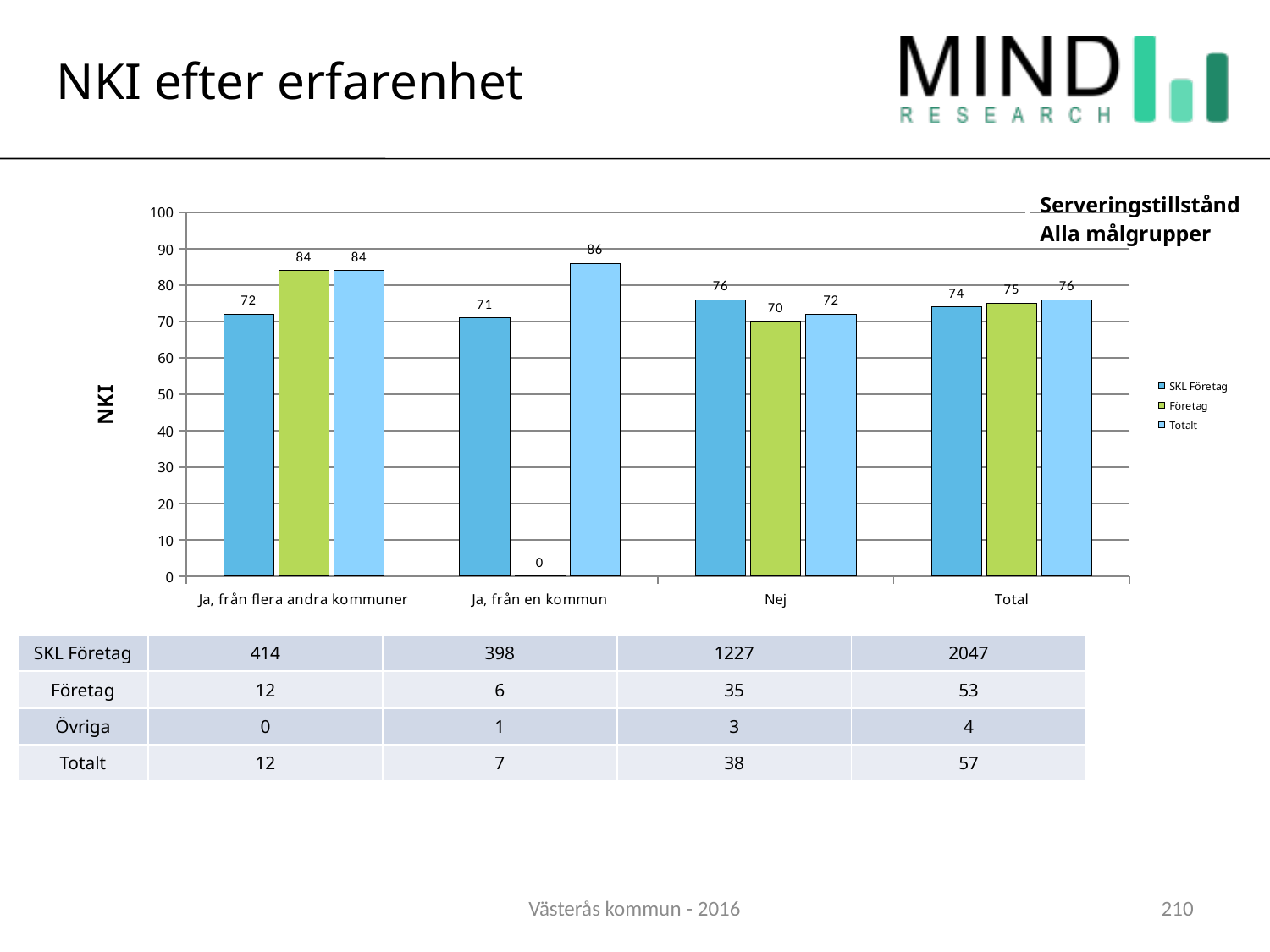
What kind of chart is shown on the slide? Bar chart In the category 'Nej', which is larger: the SKL Företag value or the Totalt value? SKL Företag What is the NKI value for SKL Företag in the category 'Ja, från flera andra kommuner'? 72 How many categories are shown on the x axis? 4 What is the NKI value for Företag in the category 'Nej'? 70 Which category has the lowest Företag value? Ja, från en kommun Which category has the highest Totalt value? Ja, från en kommun What label is shown on the y axis of the chart? NKI What is the difference between the Företag and SKL Företag values in the category 'Ja, från flera andra kommuner'? 12 How many series does the legend list? 3 What is the NKI value for Totalt in the category 'Ja, från en kommun'? 86 What is the NKI value for Företag in the category 'Total'? 75